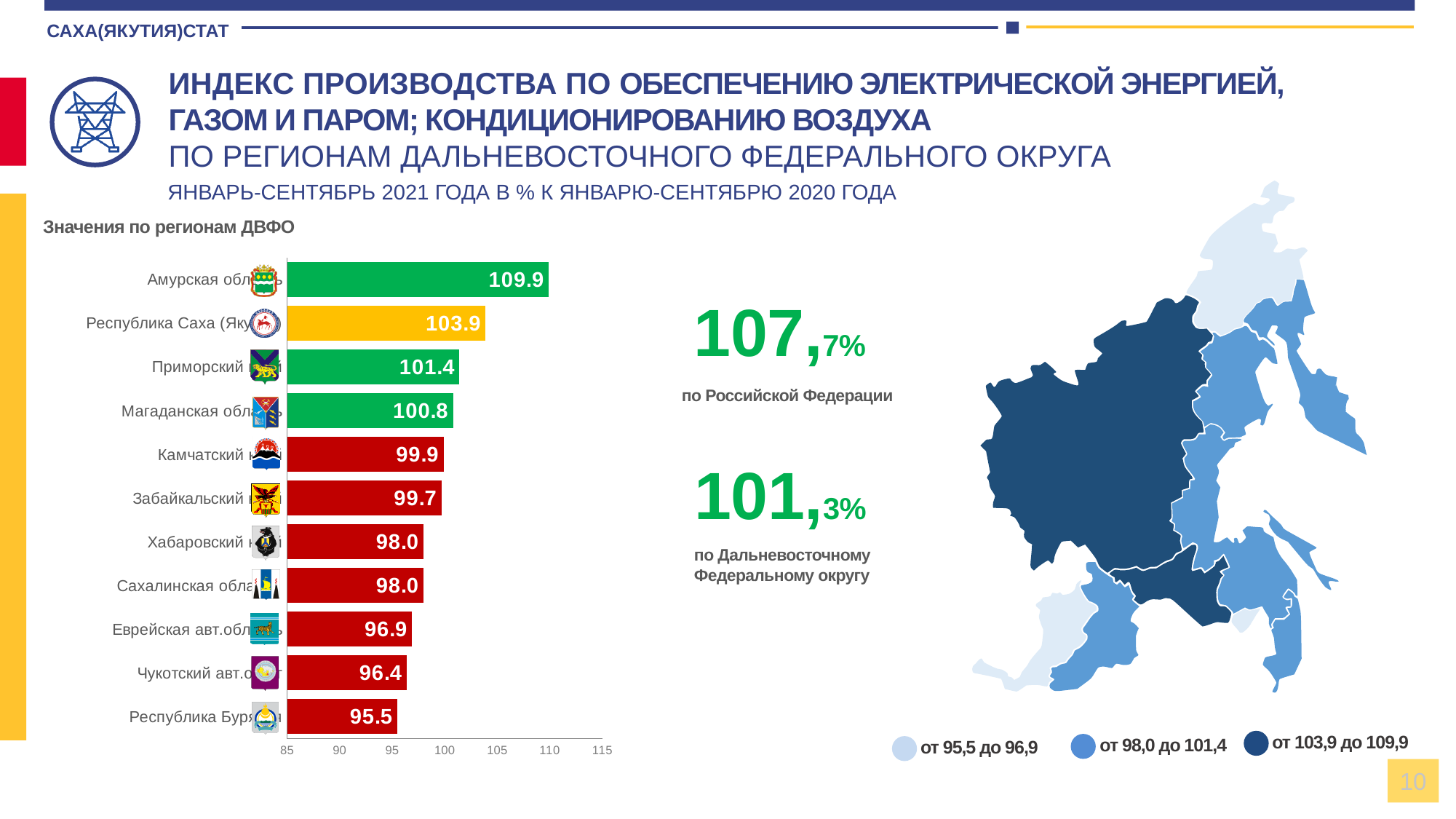
Is the value for Еврейская авт.область greater or less than 100? less Which region has the lowest value in the bar chart? Республика Бурятия What is the value for Амурская область in the bar chart? 109.9 Which is larger in the bar chart: the value for Приморский край or the value for Камчатский край? Приморский край Which region has the highest value in the bar chart? Амурская область How many regions are shown in the bar chart? 11 What colour is the bar for Республика Саха (Якутия)? yellow What type of chart is used to show the values by region? bar chart What is the value for Магаданская область in the bar chart? 100.8 What is the value for Республика Саха (Якутия) in the bar chart? 103.9 What is the difference between the values for Амурская область and Республика Саха (Якутия)? 6.0 What is the value for Чукотский авт.округ in the bar chart? 96.4